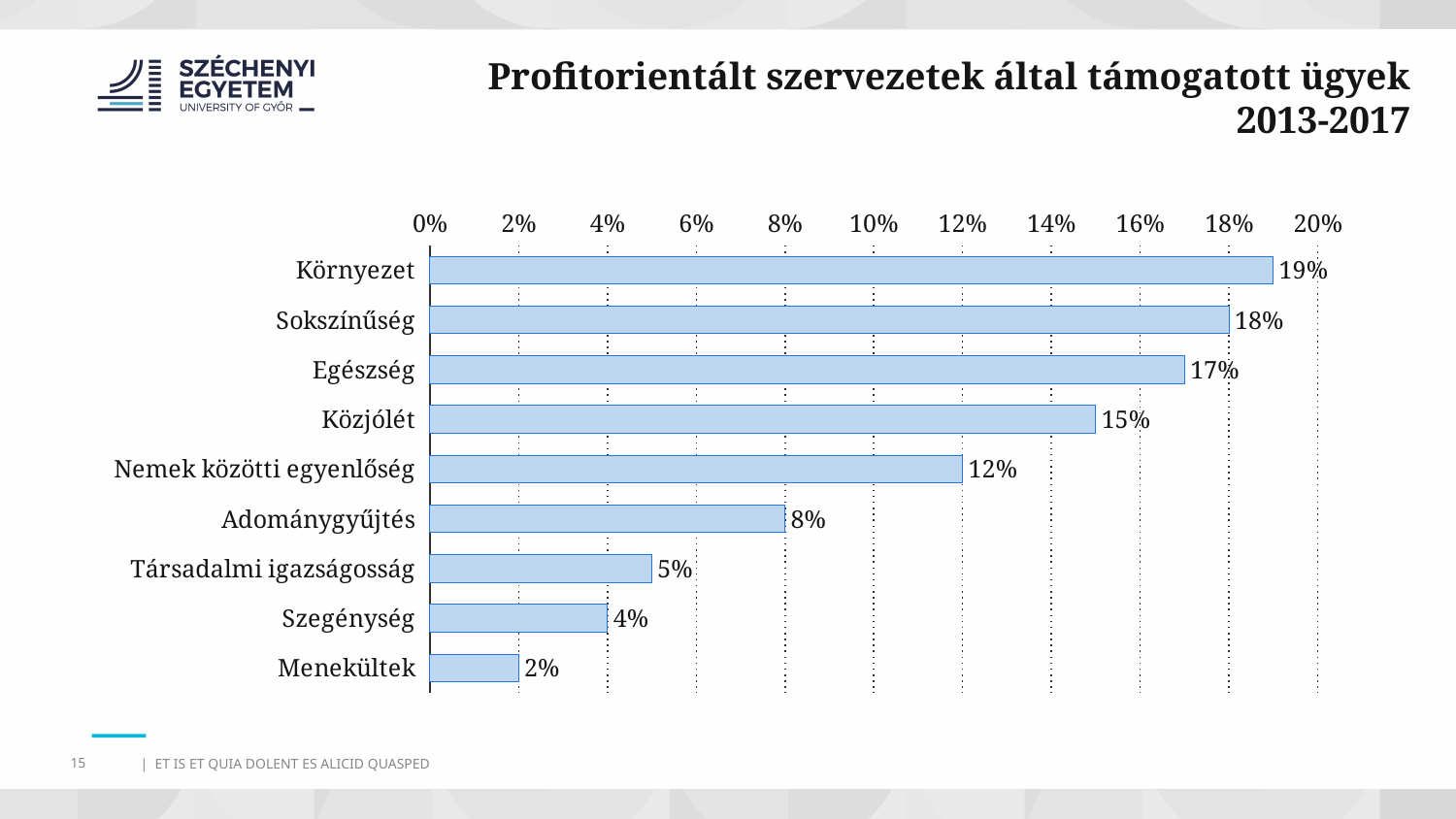
Is the value for Társadalmi igazságosság greater or less than 6%? less What is the highest value shown on the percentage axis? 20% How many categories are shown in the chart? 9 What is the value for Nemek közötti egyenlőség? 12% What is the difference between the values for Sokszínűség and Adománygyűjtés? 10% Which category has the highest value? Környezet What kind of chart is shown on the slide? bar chart What is the value for Szegénység? 4% What is the title of the chart? Profitorientált szervezetek által támogatott ügyek 2013-2017 What is the value for Környezet? 19% Which is larger, the value for Közjólét or the value for Egészség? Egészség Which category has the lowest value? Menekültek